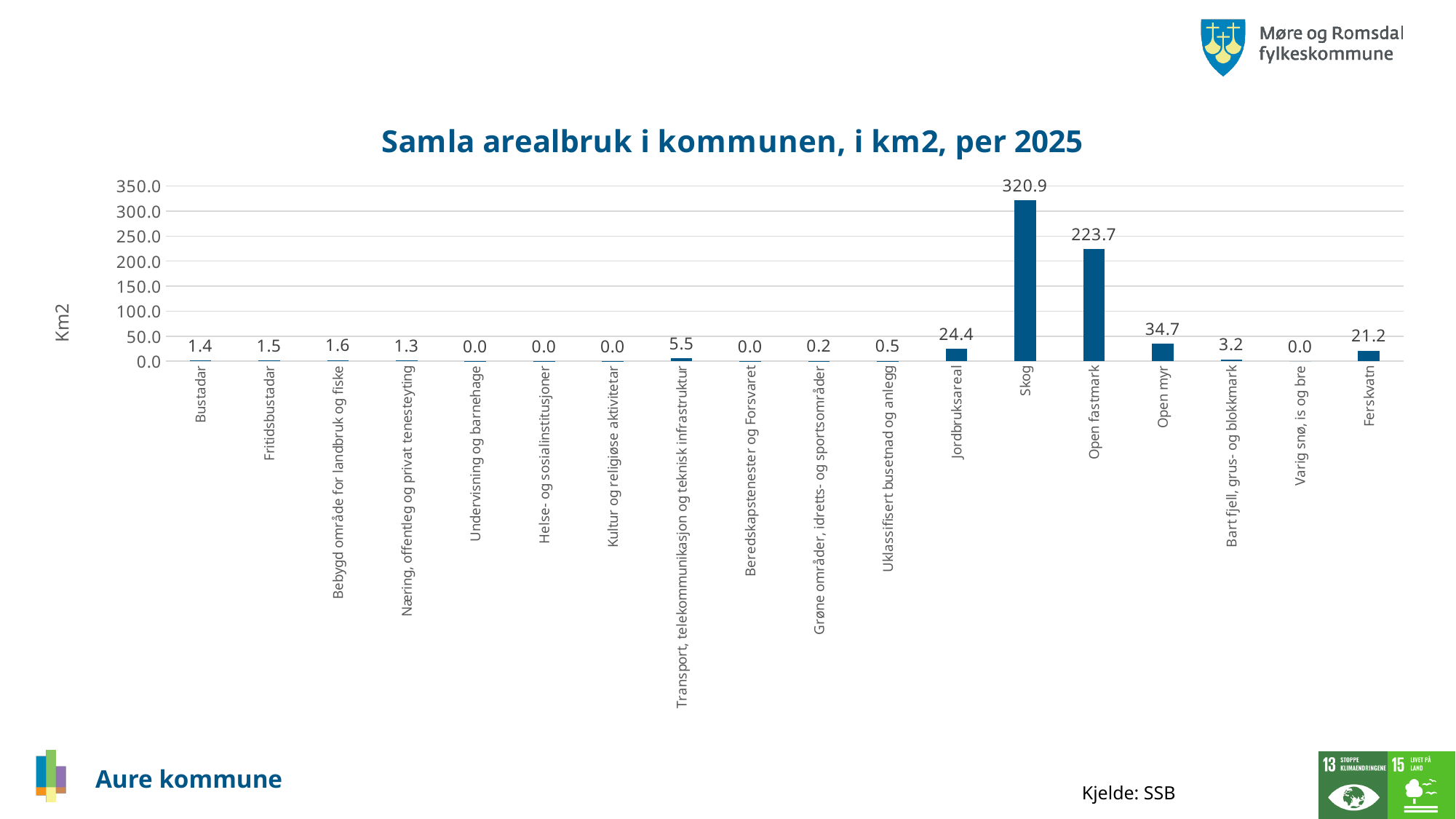
What is the difference between the values for Open myr and Jordbruksareal? 10.3 What is the title of the chart? Samla arealbruk i kommunen, i km2, per 2025 What is the value for Jordbruksareal? 24.4 What kind of chart is shown on the slide? Bar chart Is the value for Open fastmark greater or less than 200.0? greater What is the value for Ferskvatn? 21.2 Which category has the highest value? Skog How many categories are shown on the x axis? 18 Which is larger, the value for Open myr or the value for Ferskvatn? Open myr What is the difference between the values for Skog and Open fastmark? 97.2 What is the value for Skog? 320.9 What is the value for Open fastmark? 223.7